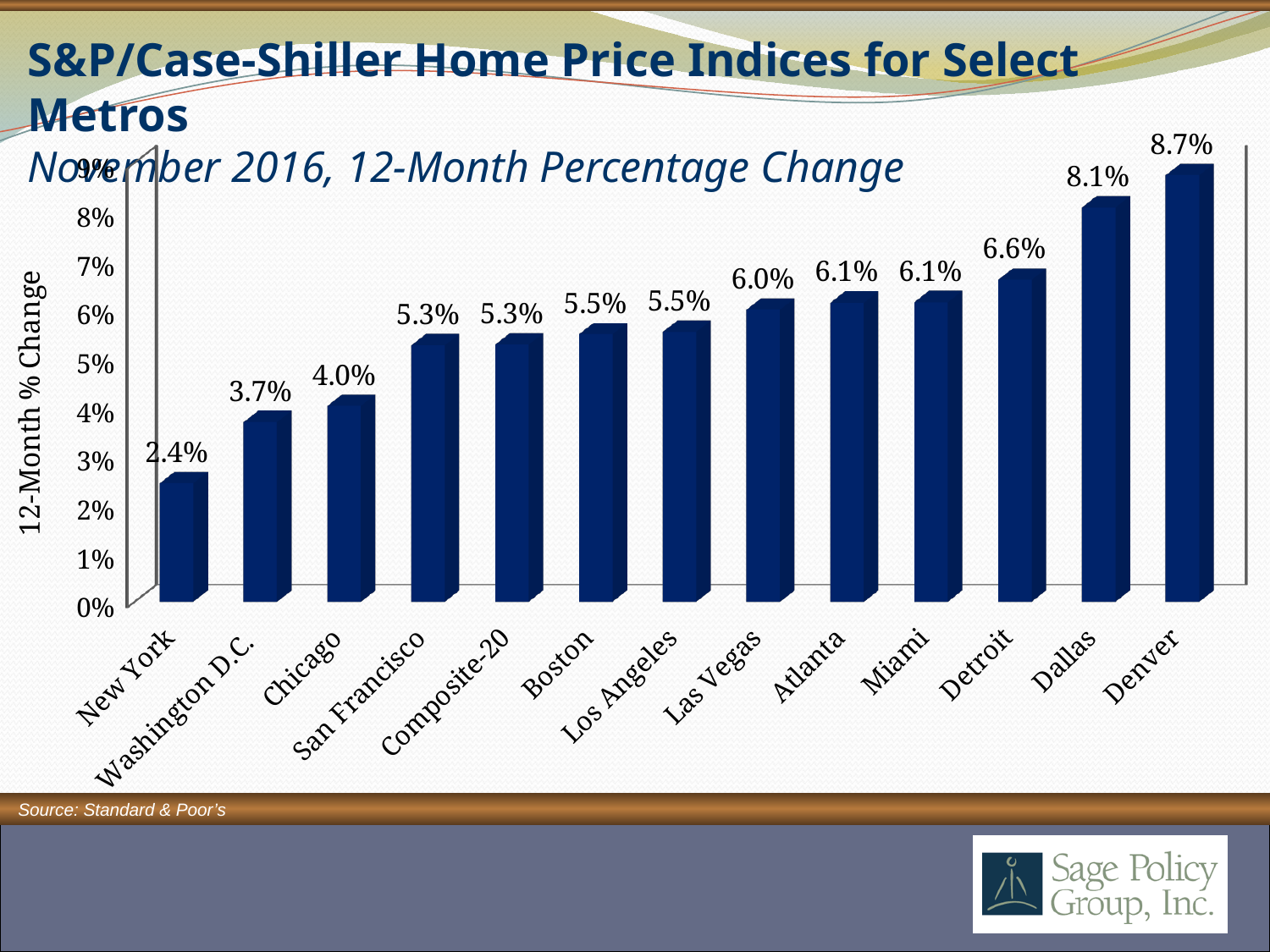
Which metro has the lowest 12-month percentage change? New York What is the 12-month percentage change for Denver? 8.7% What is the difference between the values for Dallas and Washington D.C.? 4.4% What kind of chart is shown on the slide? Bar chart How many metros (categories) are shown on the chart? 13 Which metro has the highest 12-month percentage change? Denver Which has a larger 12-month percentage change, Detroit or Chicago? Detroit What is the value shown for Composite-20? 5.3% What is the label on the vertical axis of the chart? 12-Month % Change Do the values rise or fall moving from left to right along the x axis? Rise Is the value for Las Vegas greater or less than 5%? greater What is the 12-month percentage change for New York? 2.4%